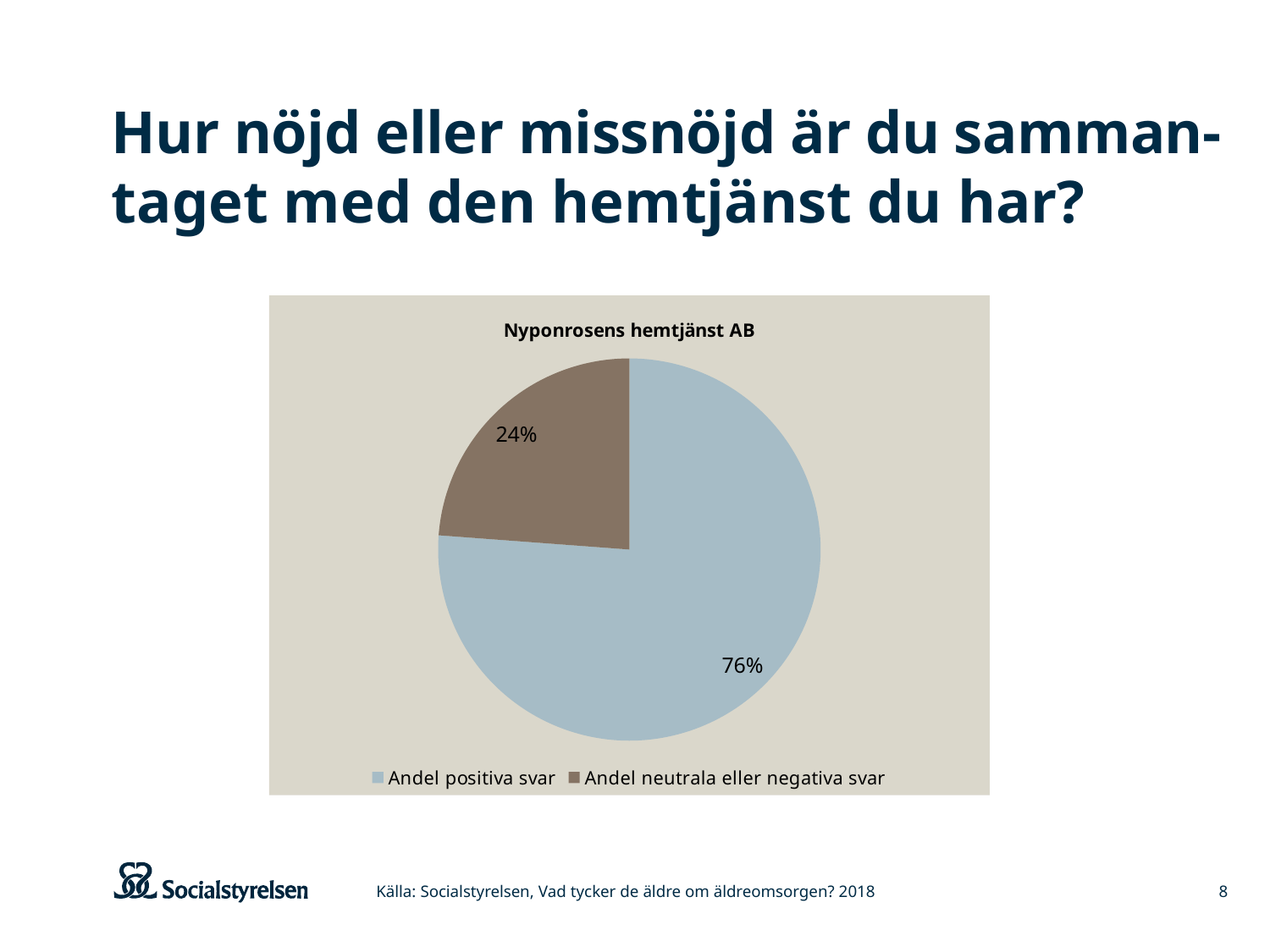
What is the value for Andel neutrala eller negativa svar? 24% Which is larger, Andel positiva svar or Andel neutrala eller negativa svar? Andel positiva svar Which legend entry is shown in brown? Andel neutrala eller negativa svar What kind of chart is shown on the slide? Pie chart What is the title of the chart? Nyponrosens hemtjänst AB What share of the pie does Andel neutrala eller negativa svar take? 24% How many slices does the pie chart have? 2 Which slice is the smallest? Andel neutrala eller negativa svar Which slice is the largest? Andel positiva svar How many entries does the legend list? 2 What is the value for Andel positiva svar? 76% What is the difference between Andel positiva svar and Andel neutrala eller negativa svar? 52%